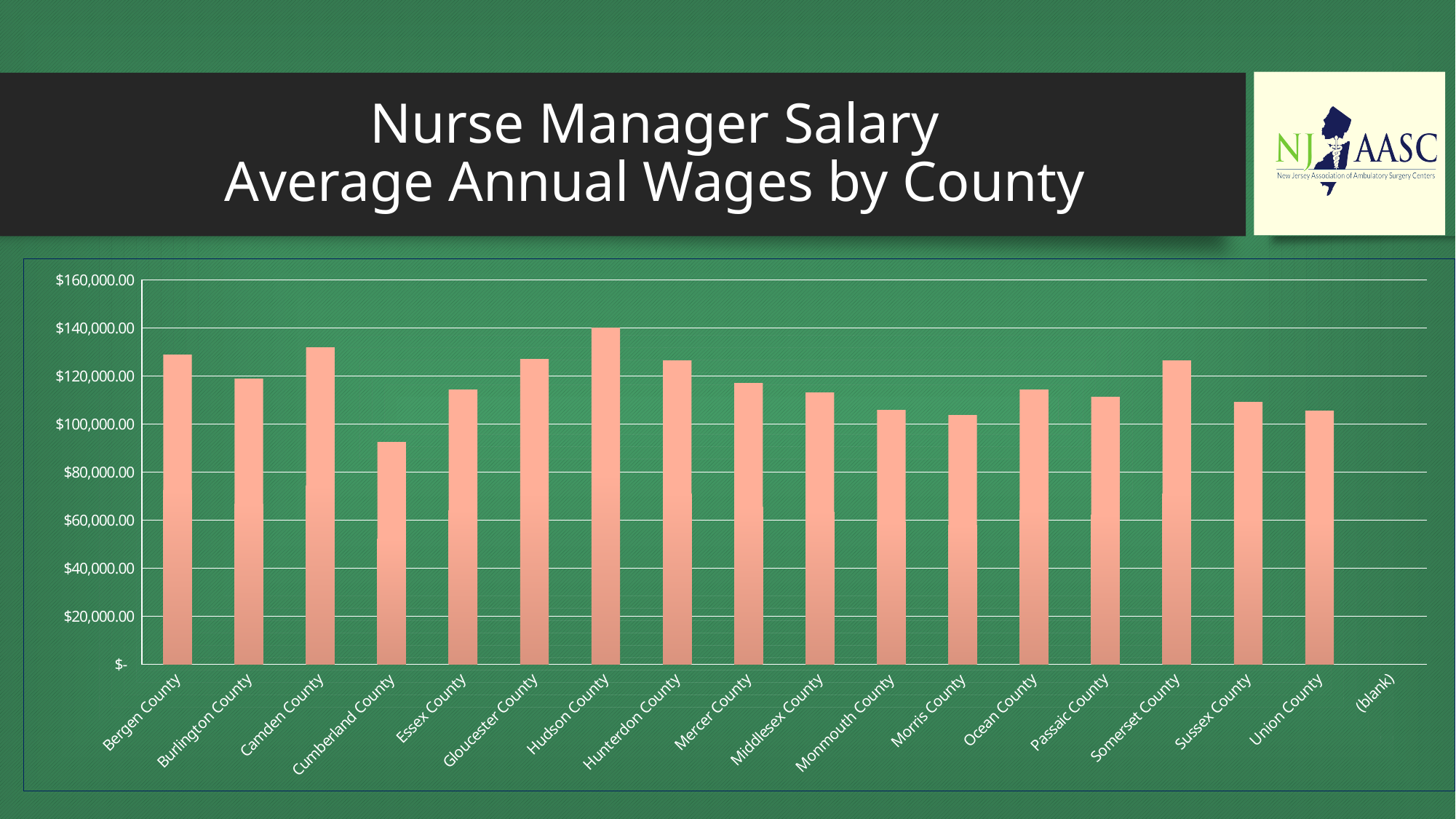
Which is larger, the value for Camden County or the value for Burlington County? Camden County How many counties have a bar plotted in the chart? 17 What kind of chart is shown on the slide? bar chart Which is larger, the value for Bergen County or the value for Essex County? Bergen County What is the title shown above the chart? Nurse Manager Salary Average Annual Wages by County Which is larger, the value for Gloucester County or the value for Mercer County? Gloucester County Is the value for Morris County greater or less than $120,000.00? less Which county has the highest average annual wage in the chart? Hudson County Is the value for Bergen County greater or less than $120,000.00? greater Which county has the lowest average annual wage in the chart? Cumberland County Is the value for Cumberland County greater or less than $100,000.00? less